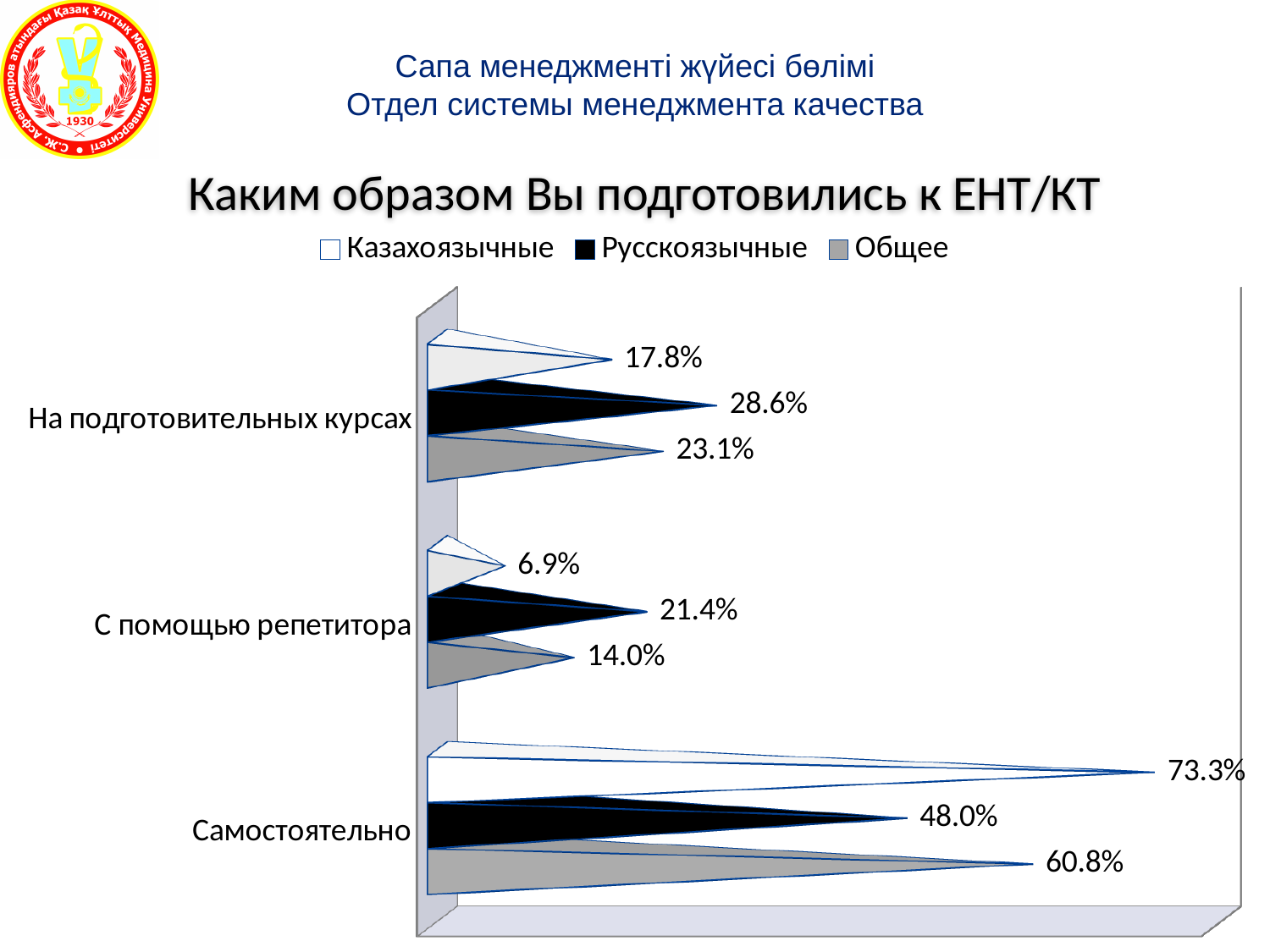
How many series does the legend list? 3 Which category has the lowest value for the Казахоязычные series? С помощью репетитора What is the title of the chart? Каким образом Вы подготовились к ЕНТ/КТ How many categories are shown on the chart? 3 Which is larger in the На подготовительных курсах category: the Казахоязычные value or the Русскоязычные value? Русскоязычные What is the difference between the Казахоязычные and Русскоязычные values in the Самостоятельно category? 25.3% What is the value for Русскоязычные in the На подготовительных курсах category? 28.6% What is the value for Общее in the С помощью репетитора category? 14.0% What is the value for Казахоязычные in the Самостоятельно category? 73.3% What kind of chart is shown on the slide? Bar chart What is the value for Казахоязычные in the С помощью репетитора category? 6.9% Which category has the highest value for the Общее series? Самостоятельно